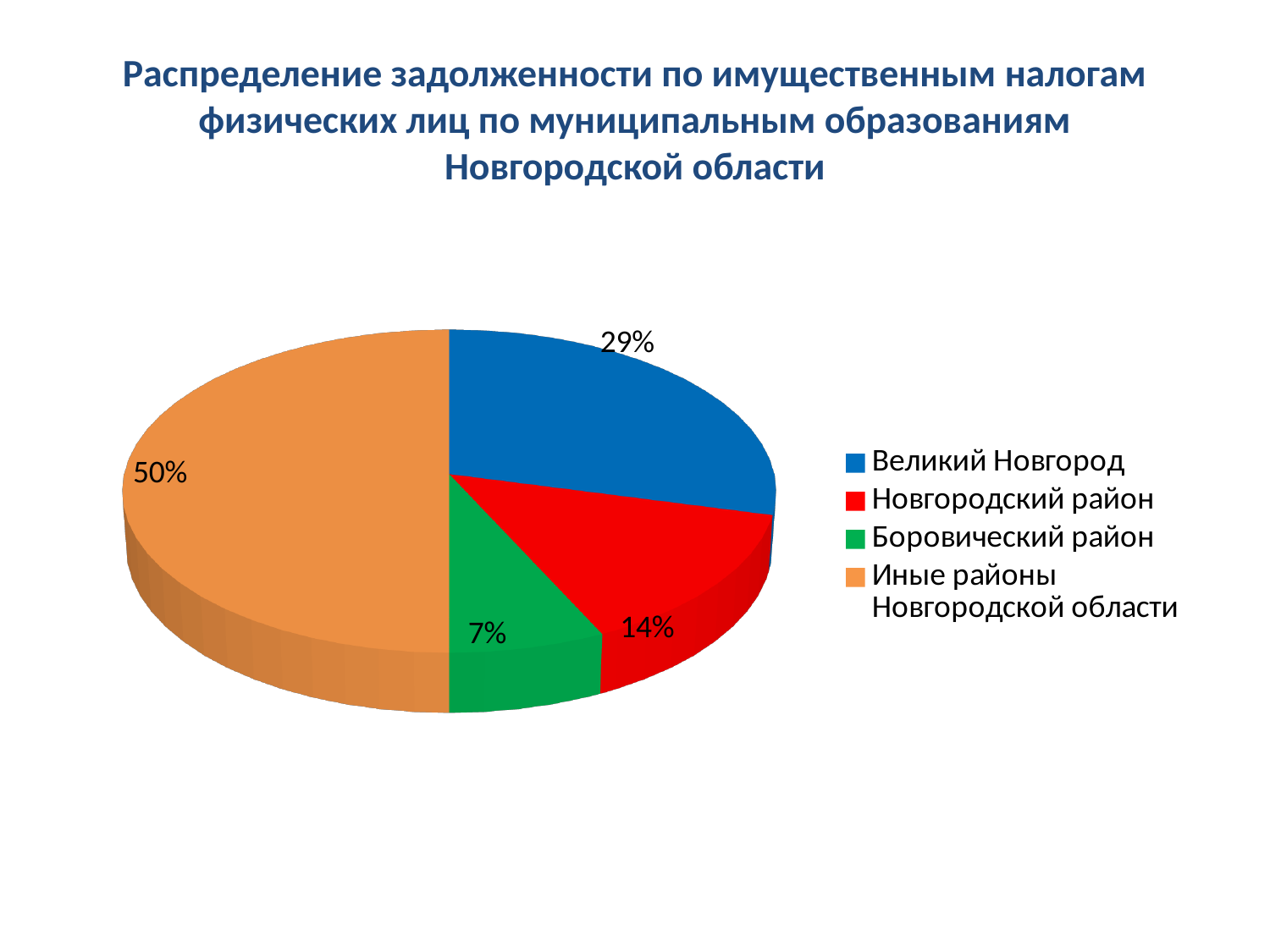
What is the value shown for Новгородский район? 14% Which category has the smallest slice of the pie? Боровический район Which is larger, the slice for Новгородский район or the slice for Боровический район? Новгородский район What share of the pie is labelled for Иные районы Новгородской области? 50% How many categories are shown in the pie chart? 4 What is the difference in percentage points between Иные районы Новгородской области and Великий Новгород? 21 What is the value shown for Боровический район? 7% Which category has the largest slice of the pie? Иные районы Новгородской области What kind of chart is shown on the slide? Pie chart What is the difference in percentage points between Великий Новгород and Новгородский район? 15 What colour is the slice for Великий Новгород? Blue What share of the pie does Великий Новгород account for? 29%